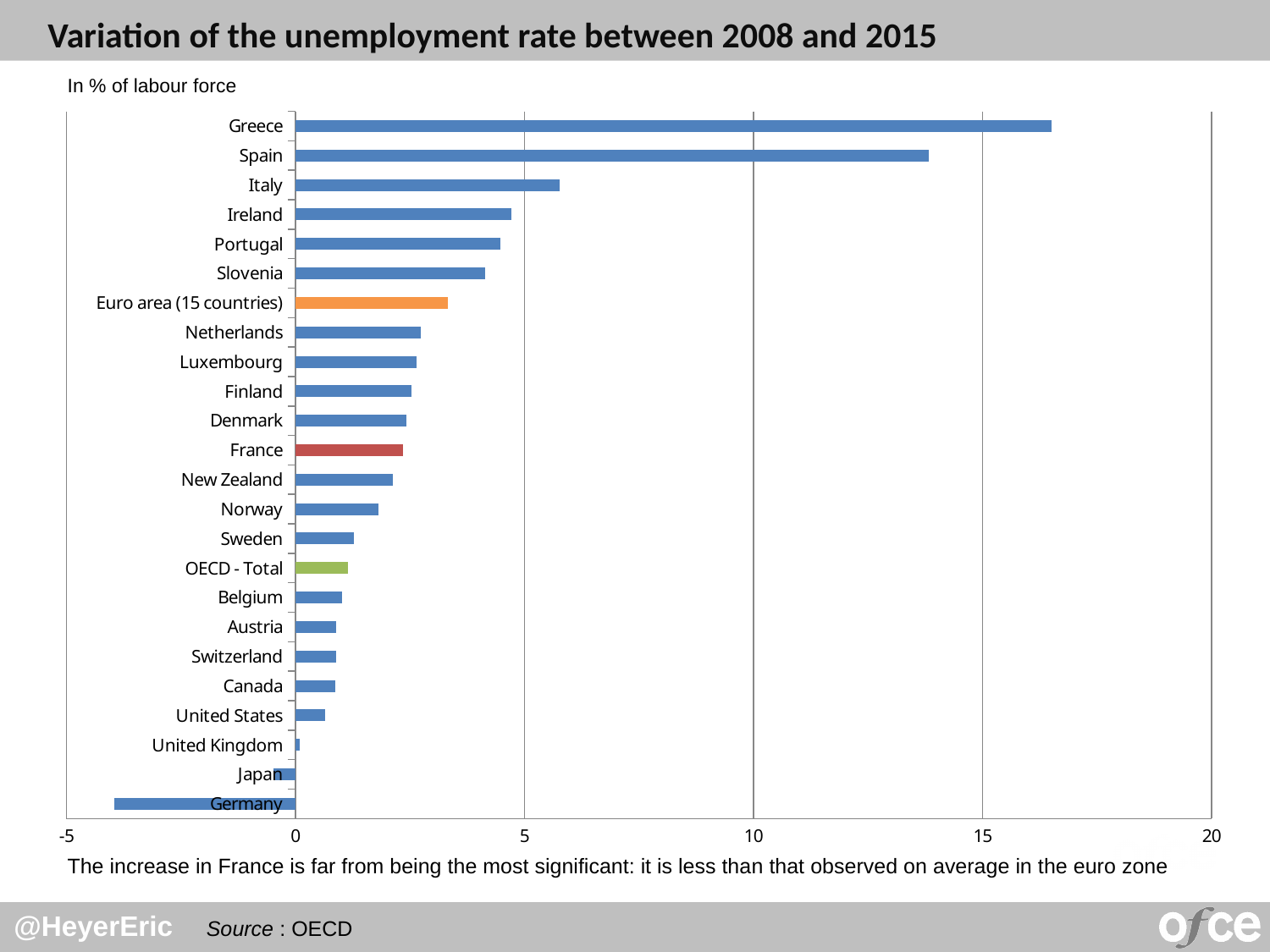
Is the value for Spain greater or less than 15? less How many categories (countries and regions) are plotted in the chart? 24 Which country or region has the highest variation of the unemployment rate between 2008 and 2015? Greece Which has the larger variation of the unemployment rate, France or Euro area (15 countries)? Euro area (15 countries) Which has the larger variation of the unemployment rate, Greece or Spain? Greece Which country or region has the lowest variation of the unemployment rate between 2008 and 2015? Germany Is the value for Italy greater or less than 5? greater Is the value for Euro area (15 countries) greater or less than 5? less What kind of chart is shown on the slide? bar chart What colour is the bar for France? red